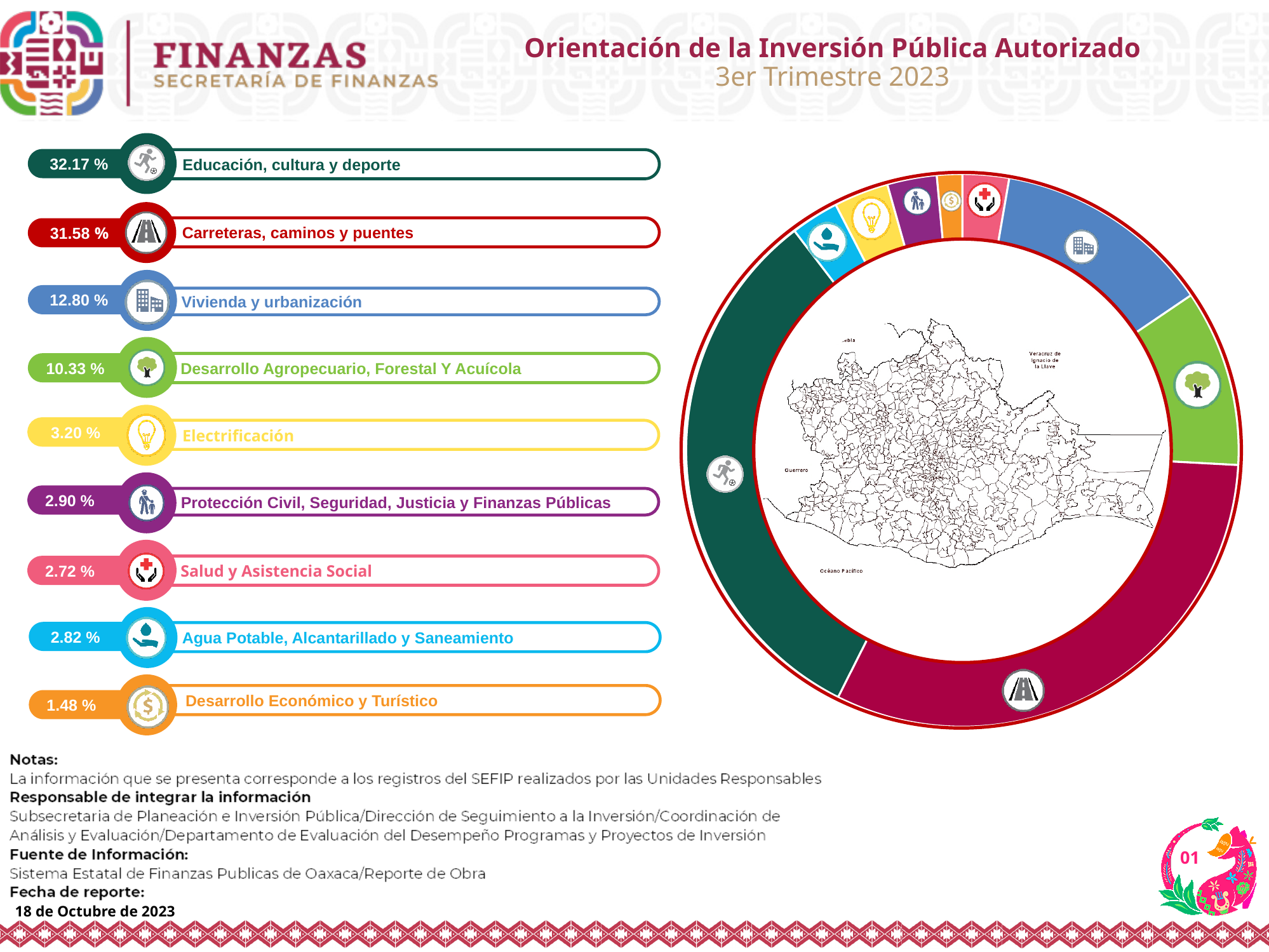
What kind of chart is shown on the right side of the slide? Pie (donut) chart How many categories are listed in the chart's legend? 9 What is the difference in percentage points between Vivienda y urbanización and Desarrollo Agropecuario, Forestal Y Acuícola? 2.47 % What percentage is shown for Electrificación? 3.20 % What percentage is shown for Vivienda y urbanización? 12.80 % What is the difference in percentage points between Educación, cultura y deporte and Carreteras, caminos y puentes? 0.59 % What percentage is shown for Educación, cultura y deporte? 32.17 % What percentage is shown for Carreteras, caminos y puentes? 31.58 % Which has a larger share: Salud y Asistencia Social or Agua Potable, Alcantarillado y Saneamiento? Agua Potable, Alcantarillado y Saneamiento Which category has the smallest share of the authorized public investment? Desarrollo Económico y Turístico Which category has the largest share of the authorized public investment? Educación, cultura y deporte What percentage is shown for Agua Potable, Alcantarillado y Saneamiento? 2.82 %